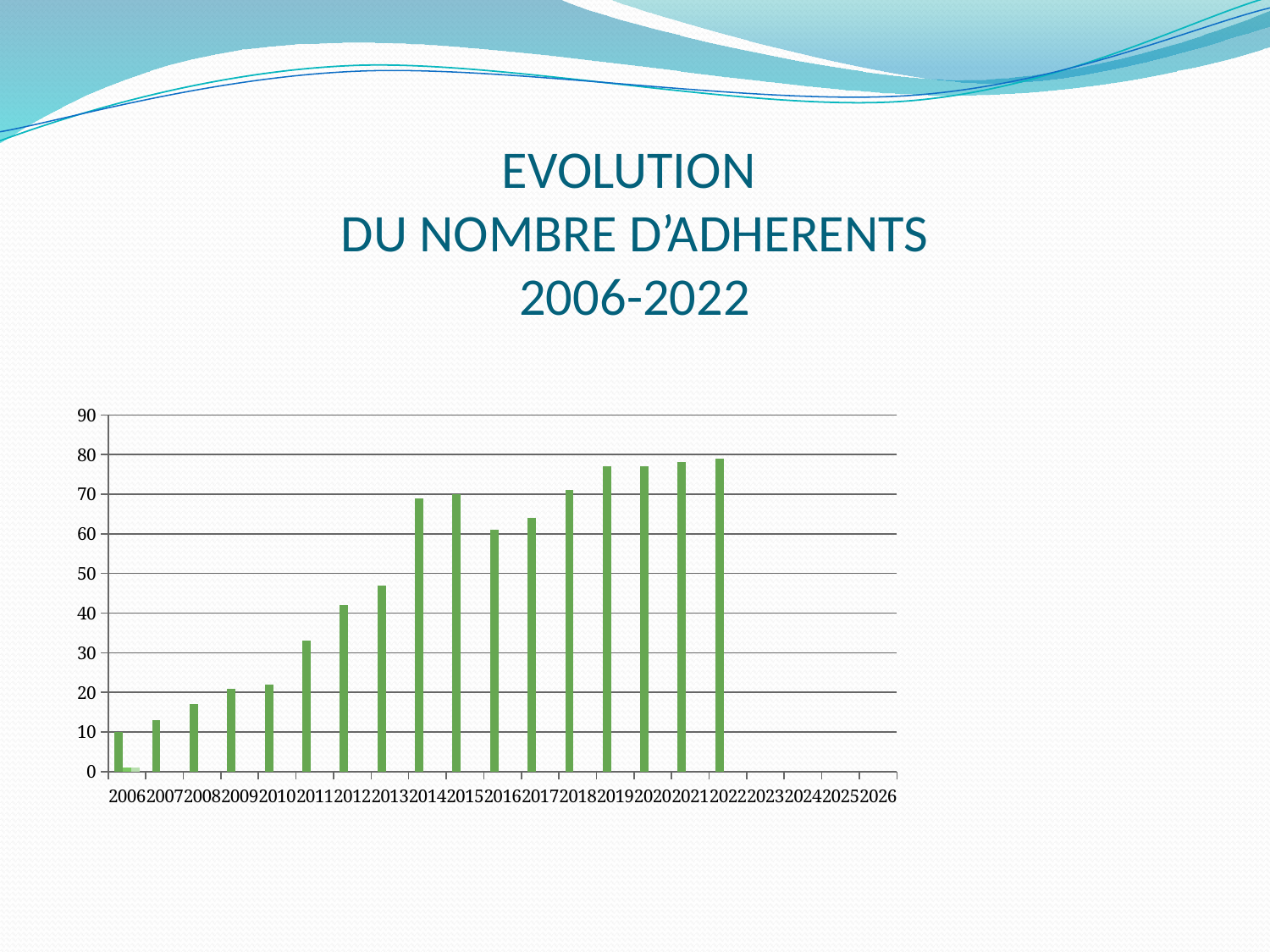
Which year has the lowest bar in the chart? 2006 Is the value for 2019 greater or less than 70? greater Is the value for 2008 greater or less than 20? less How many years have a bar plotted in the chart? 17 Is the value for 2013 greater or less than 50? less What is the highest value shown on the vertical axis? 90 Which year has the larger value, 2014 or 2016? 2014 Do the values generally rise or fall from 2006 to 2022? rise What kind of chart is shown on the slide? bar chart What is the title of the chart on the slide? EVOLUTION DU NOMBRE D'ADHERENTS 2006-2022